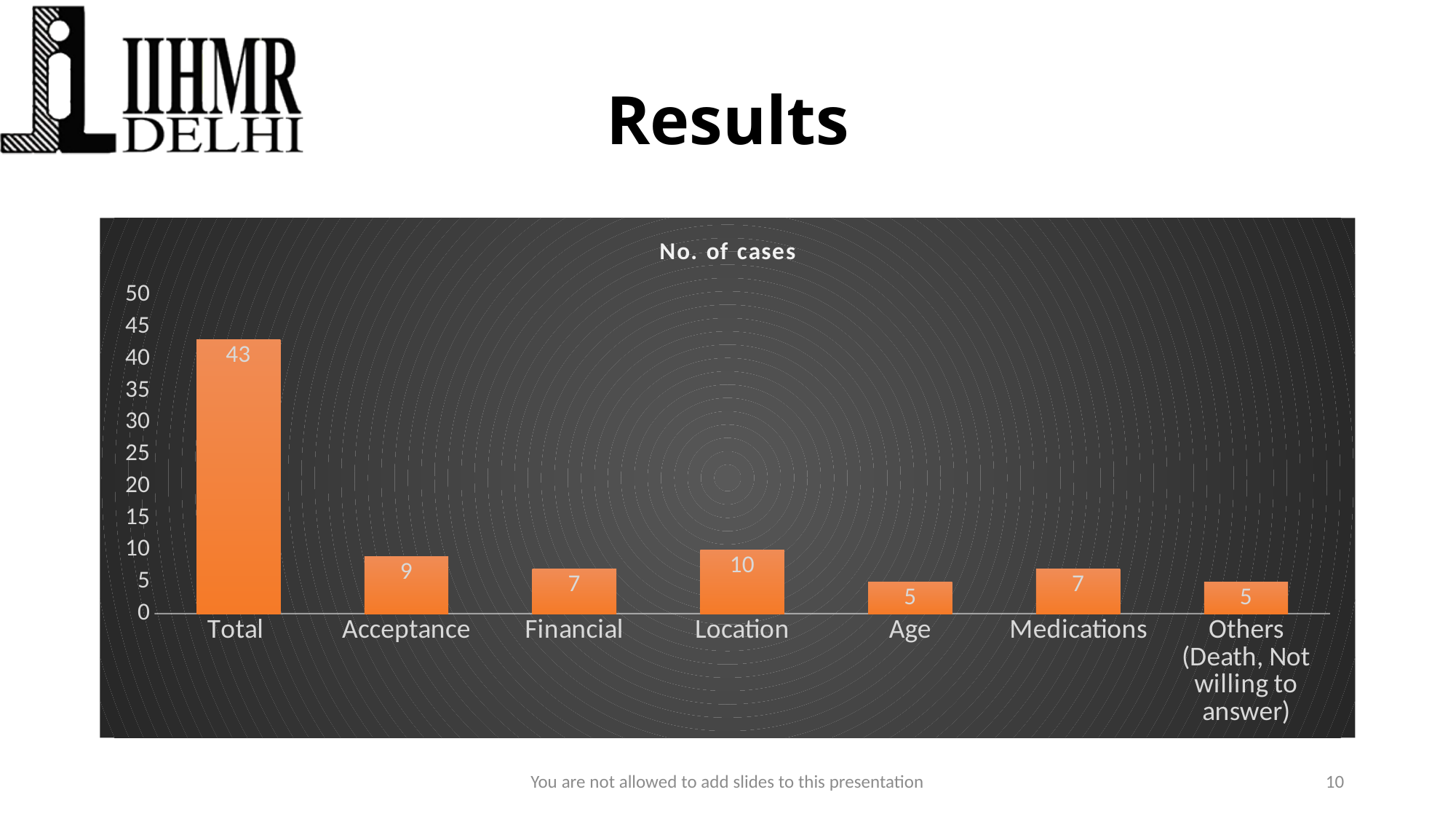
What kind of chart is shown on the slide? Bar chart Which has more cases, Acceptance or Financial? Acceptance What is the difference in number of cases between Total and Acceptance? 34 Which category has the highest number of cases? Total What is the number of cases for Acceptance? 9 What is the title of the chart? No. of cases How many categories are shown on the x axis? 7 What is the number of cases for Location? 10 What is the number of cases for Medications? 7 What is the number of cases for Total? 43 What is the difference in number of cases between Location and Age? 5 Excluding Total, which category has the highest number of cases? Location